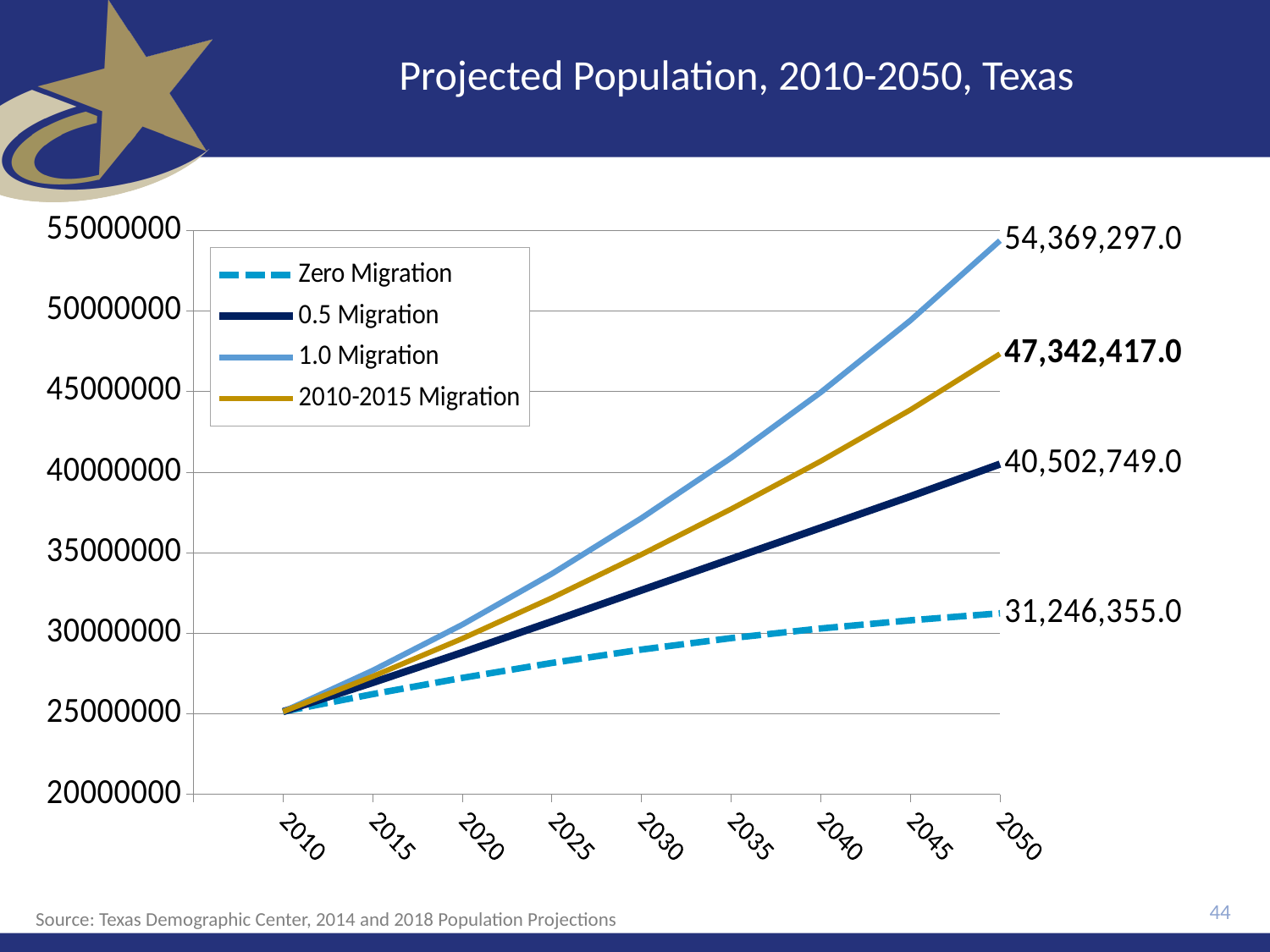
Which series has the highest projected population in 2050? 1.0 Migration What is the 2050 value for the 2010-2015 Migration series? 47,342,417.0 How many series does the legend list? 4 What is the difference between the 2050 values of the 1.0 Migration and Zero Migration series? 23,122,942.0 What is the 2050 value for the Zero Migration series? 31,246,355.0 Which series has the lowest projected population in 2050? Zero Migration Is the 1.0 Migration value in 2040 greater or less than 40000000? greater In 2050, which is larger: the 2010-2015 Migration value or the 0.5 Migration value? 2010-2015 Migration What is the 2050 value for the 0.5 Migration series? 40,502,749.0 What is the 2050 value for the 1.0 Migration series? 54,369,297.0 Is the Zero Migration value in 2030 greater or less than 30000000? less What kind of chart is shown on the slide? Line chart